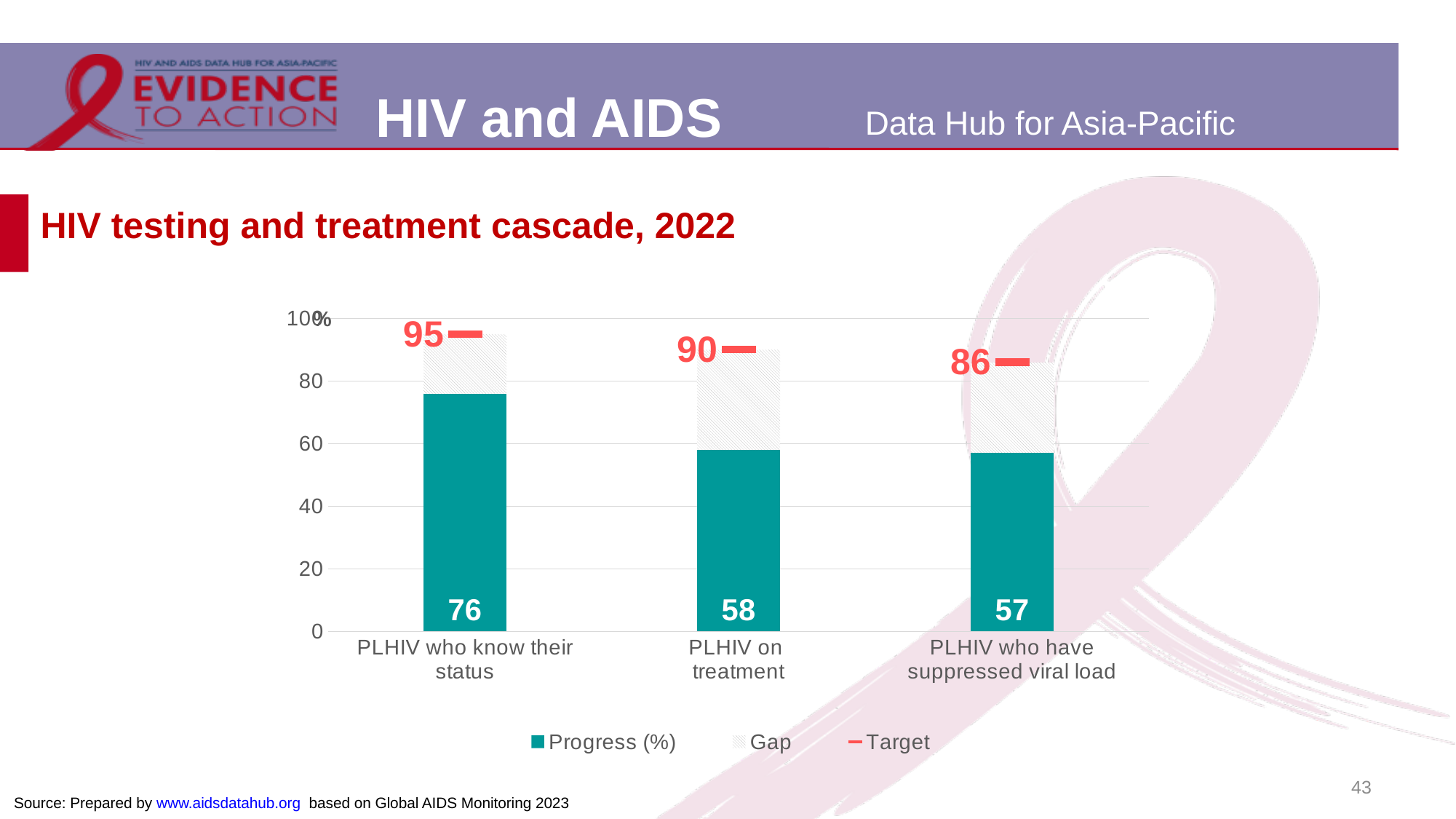
How many series does the legend list? 3 How many categories are shown on the x axis? 3 What is the Target value for PLHIV who have suppressed viral load? 86 What kind of chart is shown on the slide? bar chart What is the Progress (%) value for PLHIV who know their status? 76 What is the difference between the Target and the Progress (%) value for PLHIV who know their status? 19 Which category has the highest Progress (%) value? PLHIV who know their status What is the Progress (%) value for PLHIV who have suppressed viral load? 57 What is the Target value for PLHIV on treatment? 90 What is the Progress (%) value for PLHIV on treatment? 58 Which category has the lowest Target value? PLHIV who have suppressed viral load Is the Progress (%) value for PLHIV on treatment greater or less than the Target for PLHIV on treatment? less